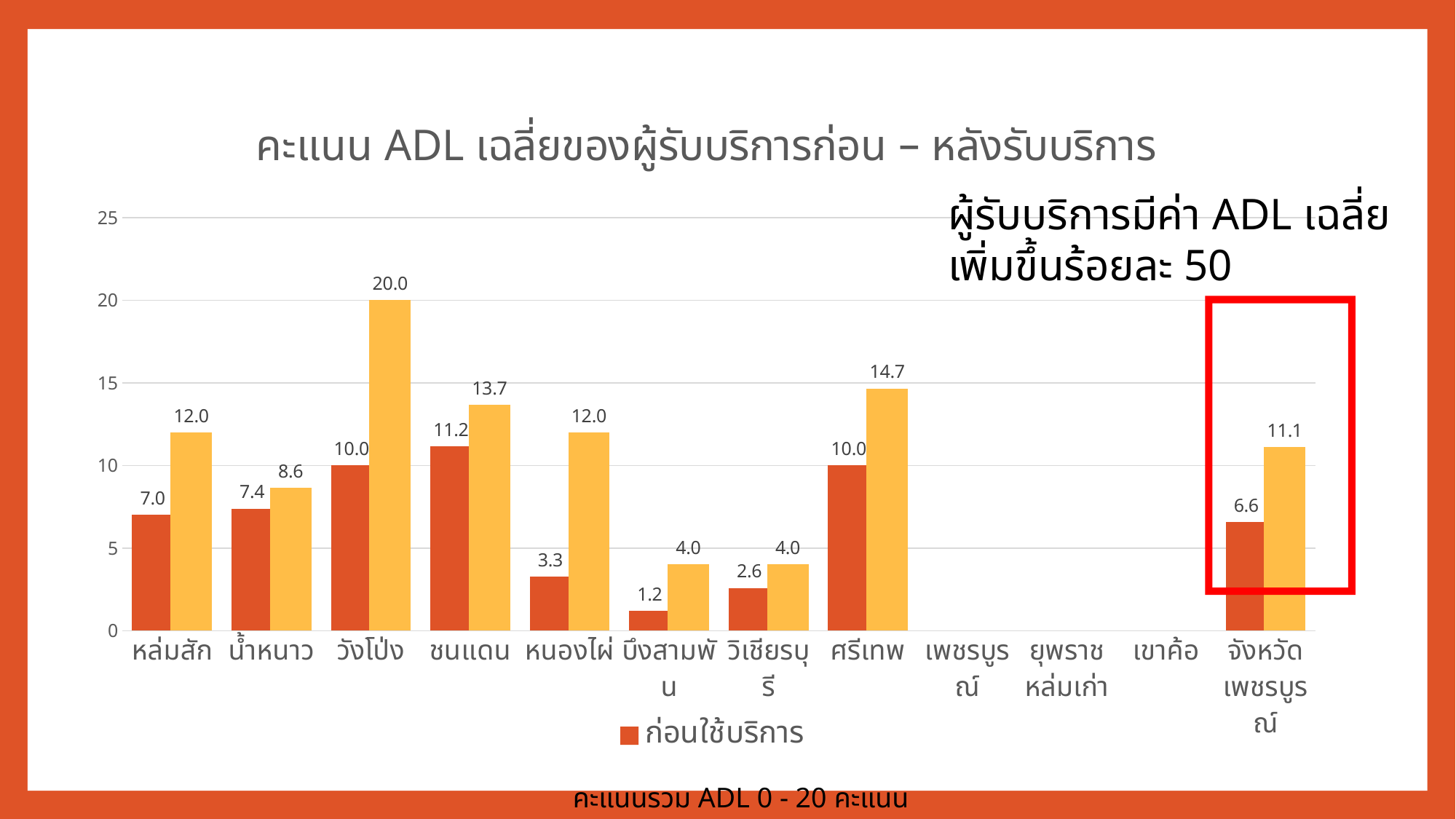
What type of chart is shown on the slide? bar chart What is the value of the ก่อนใช้บริการ (red) bar for จังหวัดเพชรบูรณ์? 6.6 Which is larger for ชนแดน: the red bar or the yellow bar? the yellow bar Which category has the highest yellow bar? วังโป่ง What is the value of the ก่อนใช้บริการ (red) bar for หล่มสัก? 7.0 What is the title of the chart? คะแนน ADL เฉลี่ยของผู้รับบริการก่อน – หลังรับบริการ What is the value of the yellow bar for ศรีเทพ? 14.7 What is the value of the yellow bar for วังโป่ง? 20.0 How many categories are shown on the x axis? 12 Which category has the lowest ก่อนใช้บริการ (red) bar among those with bars shown? บึงสามพัน What is the difference between the yellow bar and the red bar for หนองไผ่? 8.7 Is the yellow bar for น้ำหนาว greater or less than 10? less